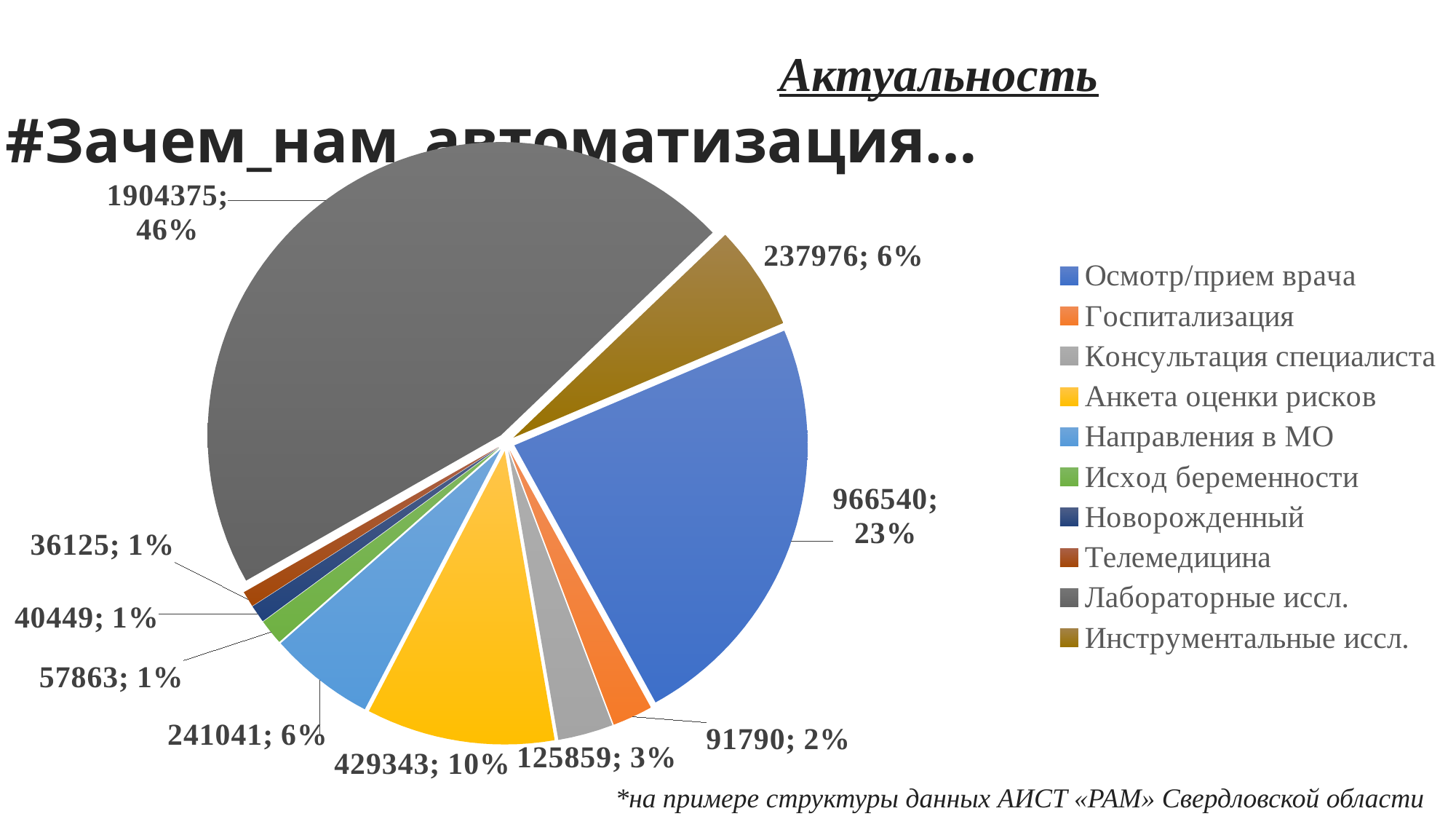
Which category has the largest slice? Лабораторные иссл. What is the value for Анкета оценки рисков? 429343 Which is larger, the value for Госпитализация or the value for Консультация специалиста? Консультация специалиста What kind of chart is shown on the slide? pie chart What is the value for Лабораторные иссл.? 1904375 What share of the pie does Направления в МО represent? 6% Which category has the smallest value? Телемедицина What share of the pie does Осмотр/прием врача represent? 23% What is the value for Осмотр/прием врача? 966540 How many slices does the pie chart have? 10 What is the difference between the values for Лабораторные иссл. and Осмотр/прием врача? 937835 How many entries does the legend list? 10